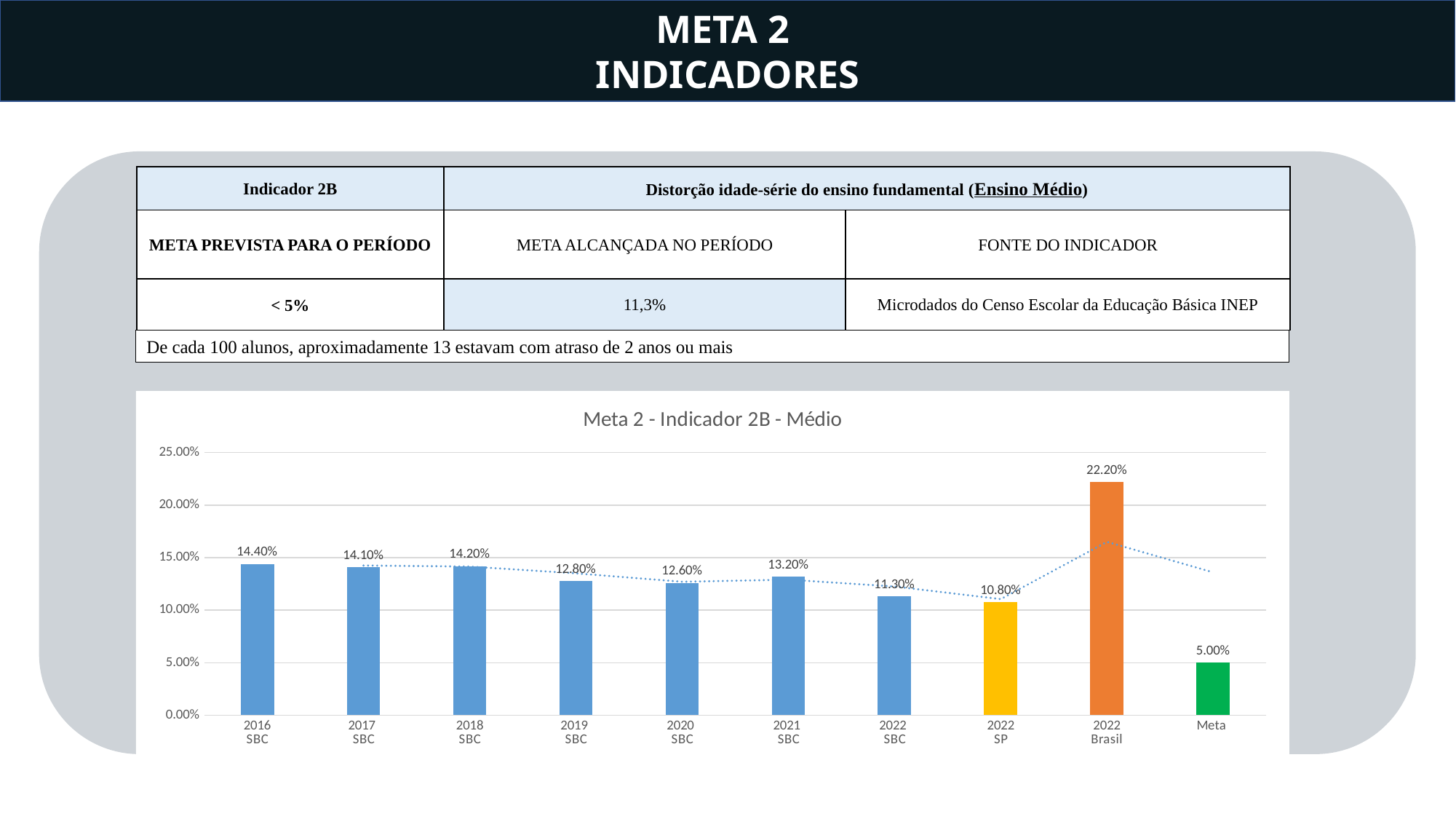
What is the value for 2016 SBC in the chart? 14.40% What is the title of the chart? Meta 2 - Indicador 2B - Médio What is the difference between the 2022 Brasil value and the 2022 SBC value? 10.90% Is the value for 2022 SBC greater or less than 15.00%? less Which is larger, the value for 2019 SBC or the value for 2021 SBC? 2021 SBC Which category has the lowest value in the chart? Meta What is the value for 2022 SP in the chart? 10.80% What is the value for 2022 Brasil in the chart? 22.20% What is the value of the Meta bar in the chart? 5.00% How many bars are plotted in the chart? 10 What kind of chart is shown on the slide? bar chart Which category has the highest value in the chart? 2022 Brasil